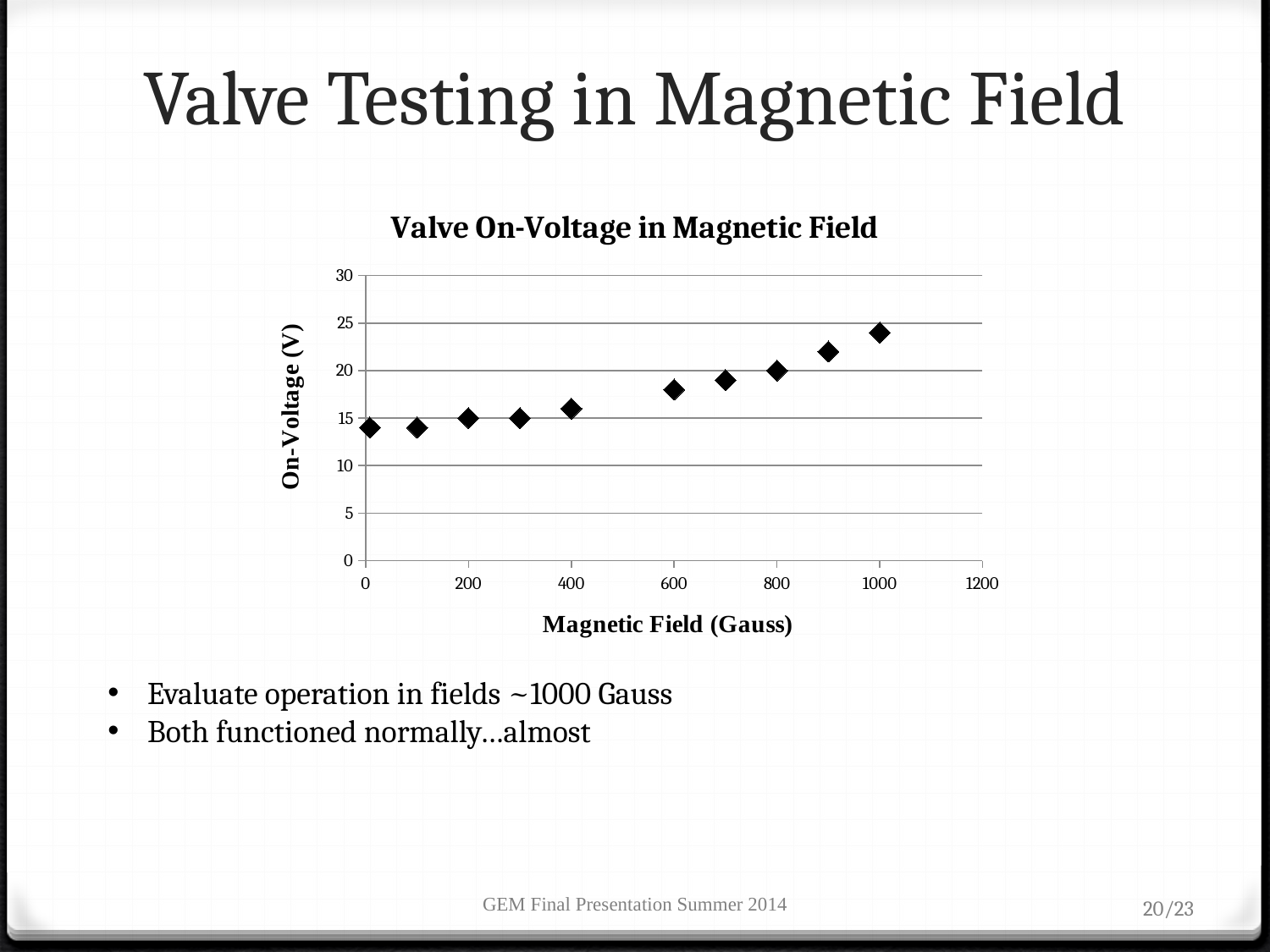
What kind of chart is shown on the slide? scatter chart How many data points are plotted on the chart? 10 At which magnetic field value is the on-voltage highest? 1000 Is the on-voltage at 900 Gauss greater or less than 25? less What is the on-voltage at 800 Gauss? 20 Is the on-voltage at 600 Gauss greater or less than 15? greater Is the on-voltage at 0 Gauss greater or less than 15? less Does the on-voltage rise or fall as the magnetic field increases? rise What is the title of the chart? Valve On-Voltage in Magnetic Field What is the label of the y axis? On-Voltage (V) Which has the larger on-voltage, 1000 Gauss or 0 Gauss? 1000 Gauss